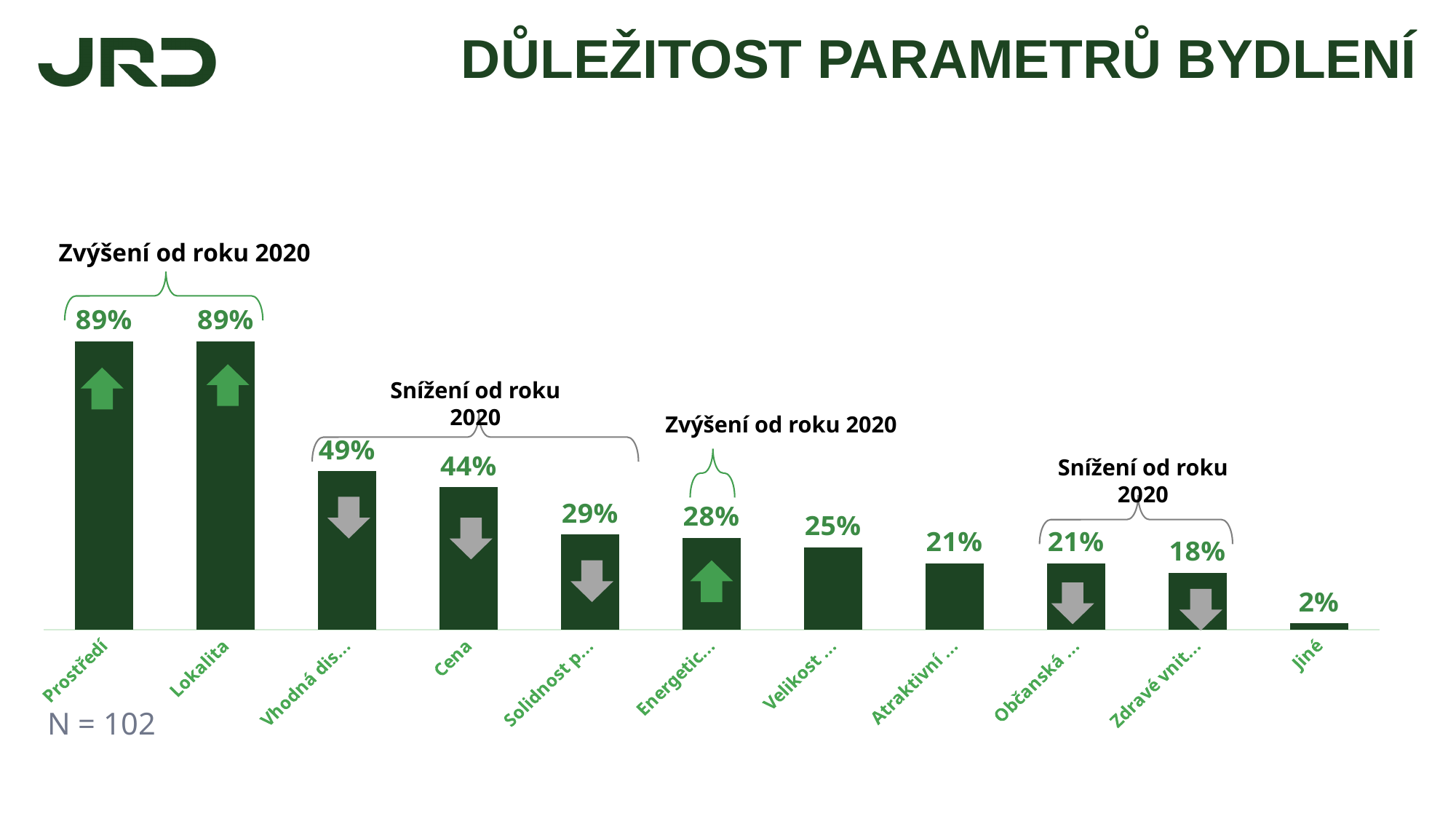
What is the value for Jiné? 2% Which category has the lowest value? Jiné Are the values for Prostředí and Lokalita equal? Yes What is the value for Prostředí? 89% What is the highest value shown in the chart? 89% What is the difference between the values for Prostředí and Cena? 45% What kind of chart is shown on the slide? Bar chart What is the value for Cena? 44% Which is larger, the value for Cena or the value for Lokalita? Lokalita What is the value for Lokalita? 89% Do the values rise or fall from left to right along the x axis? Fall How many bars are in the chart? 11